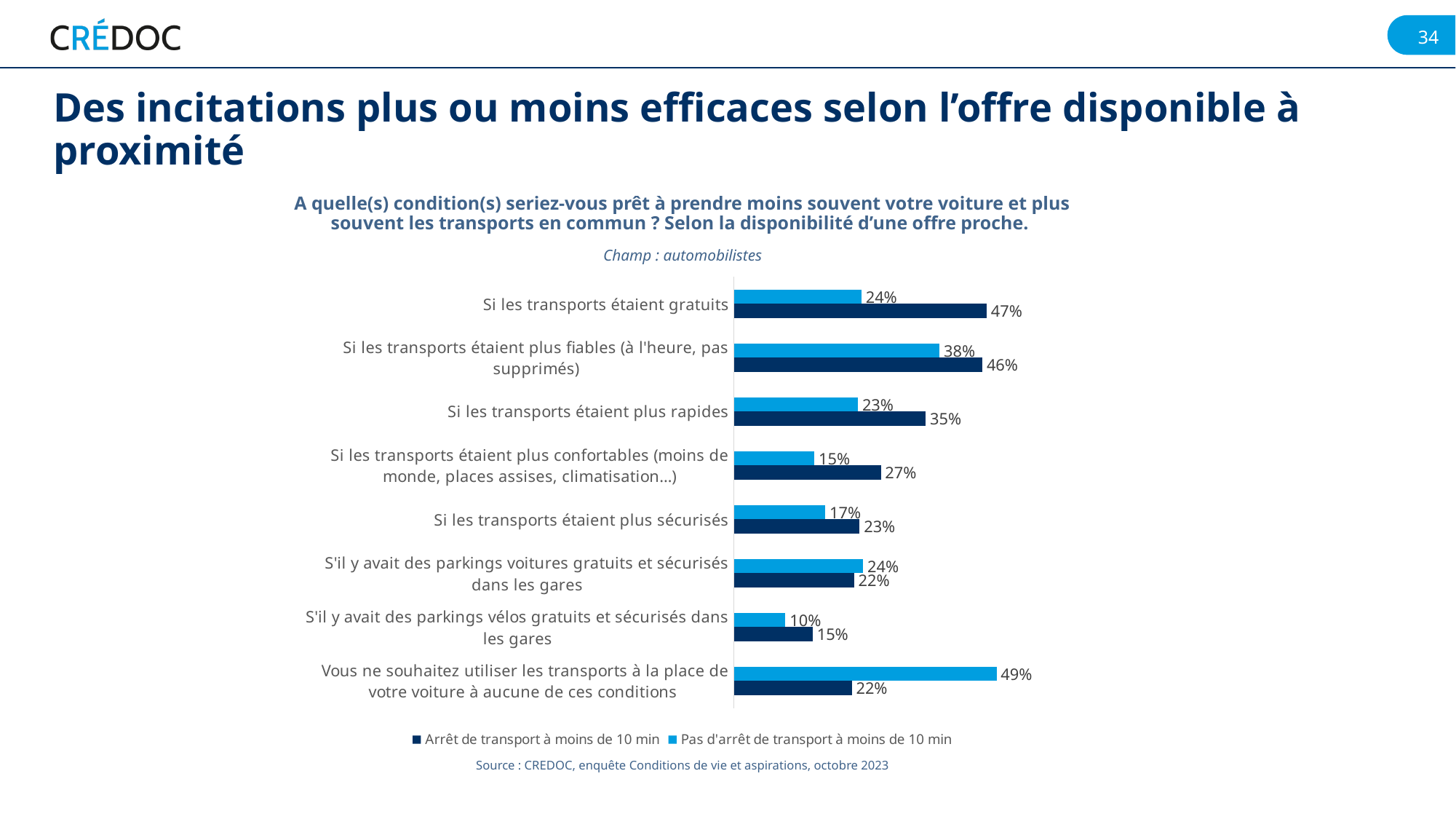
Which category has the lowest value in the "Arrêt de transport à moins de 10 min" series? S'il y avait des parkings vélos gratuits et sécurisés dans les gares What kind of chart is shown on the slide? Bar chart What is the value for "Si les transports étaient gratuits" in the "Arrêt de transport à moins de 10 min" series? 47% For "Si les transports étaient plus rapides", which series has the larger value? Arrêt de transport à moins de 10 min What is the value for "S'il y avait des parkings vélos gratuits et sécurisés dans les gares" in the "Pas d'arrêt de transport à moins de 10 min" series? 10% What is the source cited below the chart? CREDOC, enquête Conditions de vie et aspirations, octobre 2023 How many series does the legend list? 2 Which category has the highest value in the "Pas d'arrêt de transport à moins de 10 min" series? Vous ne souhaitez utiliser les transports à la place de votre voiture à aucune de ces conditions What is the difference between the two series for "Si les transports étaient gratuits"? 23 percentage points What is the value for "Si les transports étaient plus fiables (à l'heure, pas supprimés)" in the "Pas d'arrêt de transport à moins de 10 min" series? 38% How many categories (conditions) are shown on the chart? 8 For "S'il y avait des parkings voitures gratuits et sécurisés dans les gares", which series has the larger value? Pas d'arrêt de transport à moins de 10 min